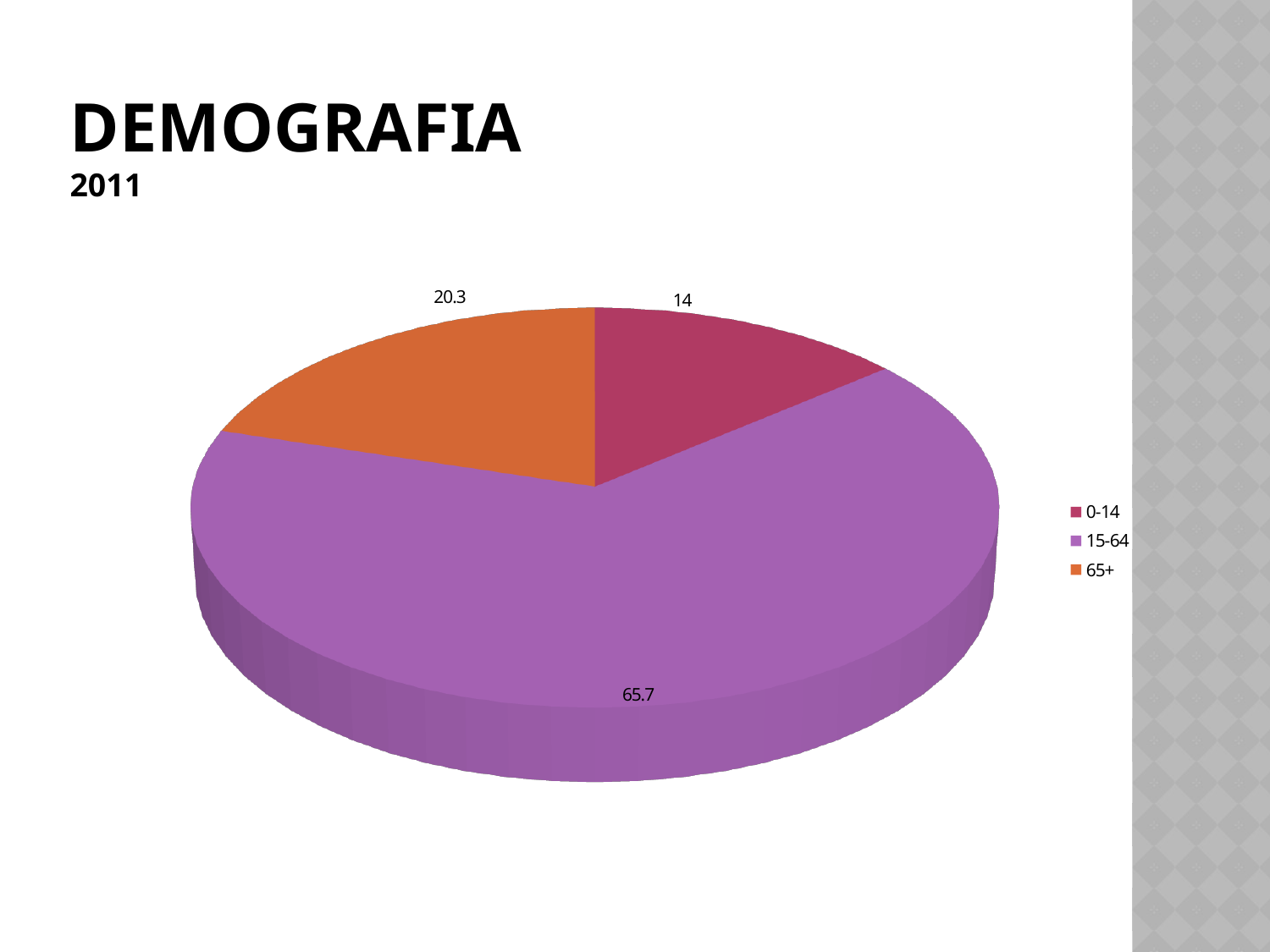
What is the difference between the values for 65+ and 0-14? 6.3 How many slices does the pie chart have? 3 What colour is the slice for the 15-64 age group? Purple What kind of chart is shown on the slide? Pie chart What is the total of the three slice values? 100 What is the value for the 15-64 age group? 65.7 What is the value for the 0-14 age group? 14 Which is larger, the value for 65+ or the value for 0-14? 65+ What is the difference between the values for 15-64 and 65+? 45.4 What is the value for the 65+ age group? 20.3 Which age group has the smallest slice? 0-14 Which age group has the largest slice? 15-64